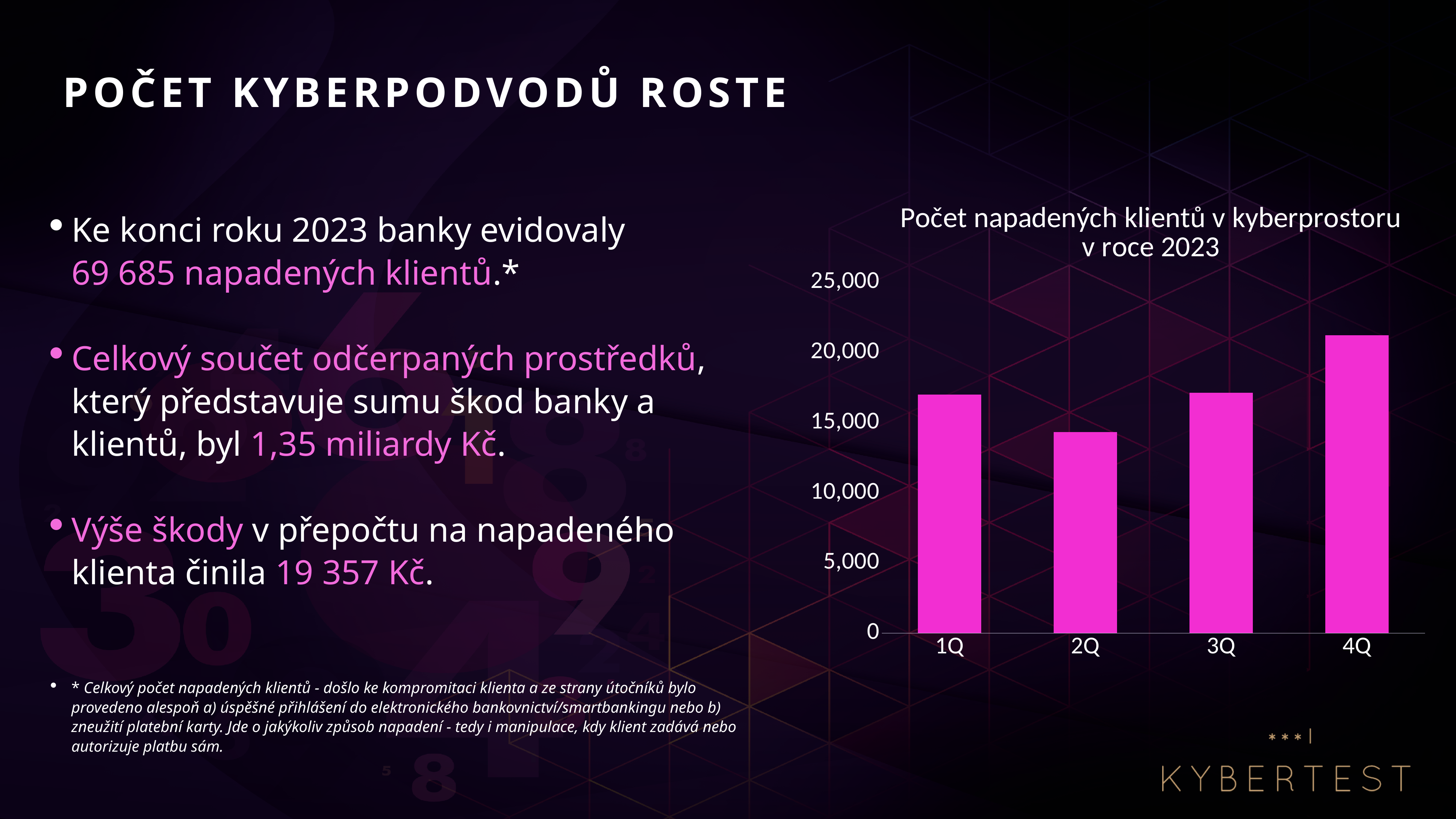
Is the value for 3Q greater or less than 20,000? less Which quarter has the highest number of attacked clients? 4Q What is the highest value shown on the chart's vertical axis? 25,000 What kind of chart is shown on the slide? bar chart Which quarter has the lowest number of attacked clients? 2Q Is the value for 2Q greater or less than 15,000? less Which is larger, the value for 1Q or the value for 2Q? 1Q How many quarters are plotted in the chart? 4 Which is larger, the value for 4Q or the value for 2Q? 4Q Is the value for 4Q greater or less than 20,000? greater What is the title of the chart? Počet napadených klientů v kyberprostoru v roce 2023